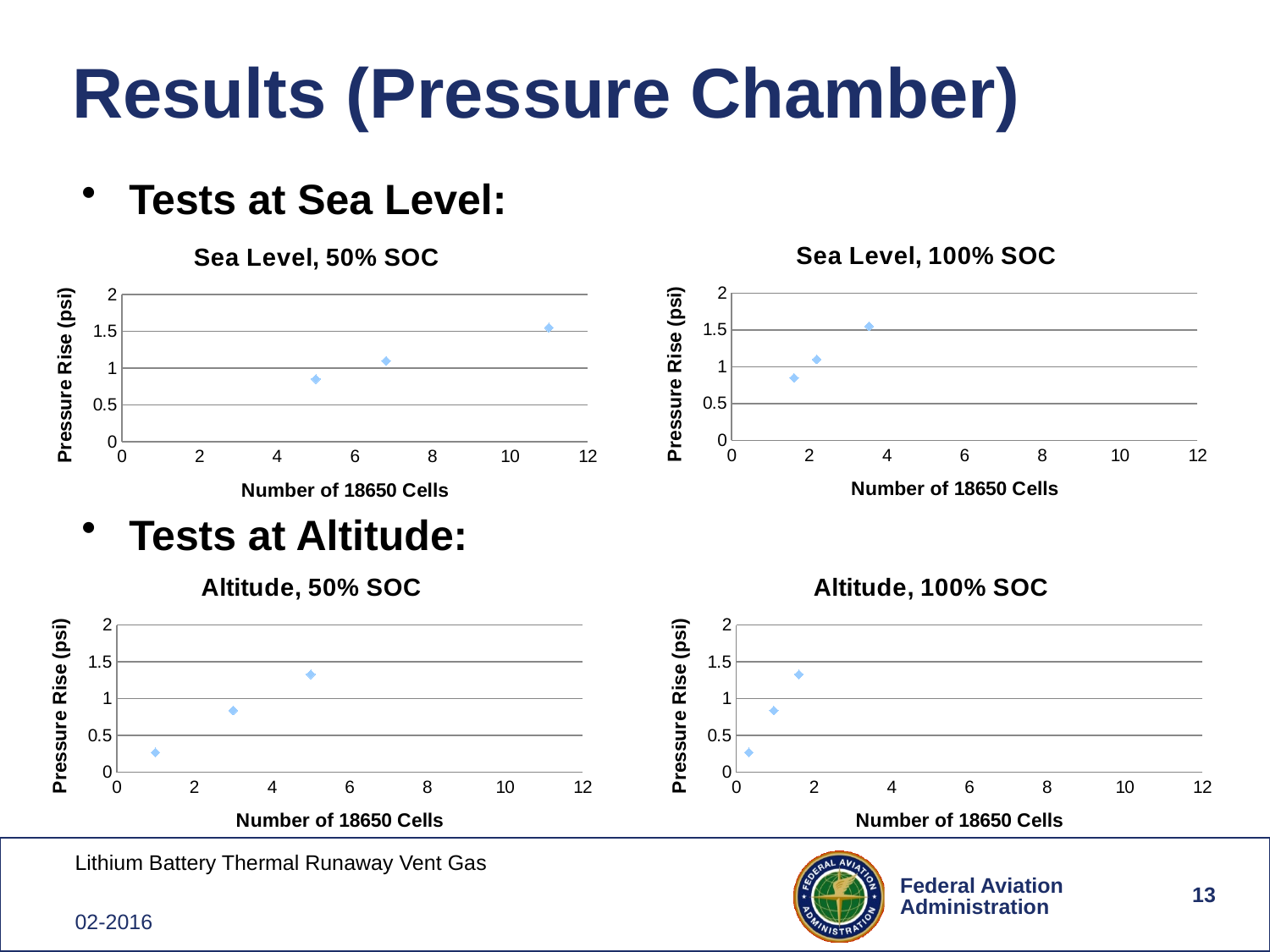
In the Altitude, 50% SOC chart, which point has the highest pressure rise? the point at 5 cells What kind of chart is the Sea Level, 50% SOC chart? scatter chart What is the y-axis label on the Sea Level, 100% SOC chart? Pressure Rise (psi) In the Sea Level, 50% SOC chart, is the pressure rise for the point at about 11 cells greater or less than 1? greater How many data points are plotted in the Altitude, 100% SOC chart? 3 In the Sea Level, 50% SOC chart, does pressure rise increase or decrease as the number of 18650 cells increases? increase In the Altitude, 50% SOC chart, does pressure rise increase or decrease as the number of cells increases? increase In the Altitude, 50% SOC chart, is the pressure rise for the point at 5 cells greater or less than 1? greater What is the x-axis label on the Altitude, 100% SOC chart? Number of 18650 Cells In the Altitude, 50% SOC chart, is the pressure rise for the point at 1 cell greater or less than 0.5? less How many data points are plotted in the Sea Level, 50% SOC chart? 3